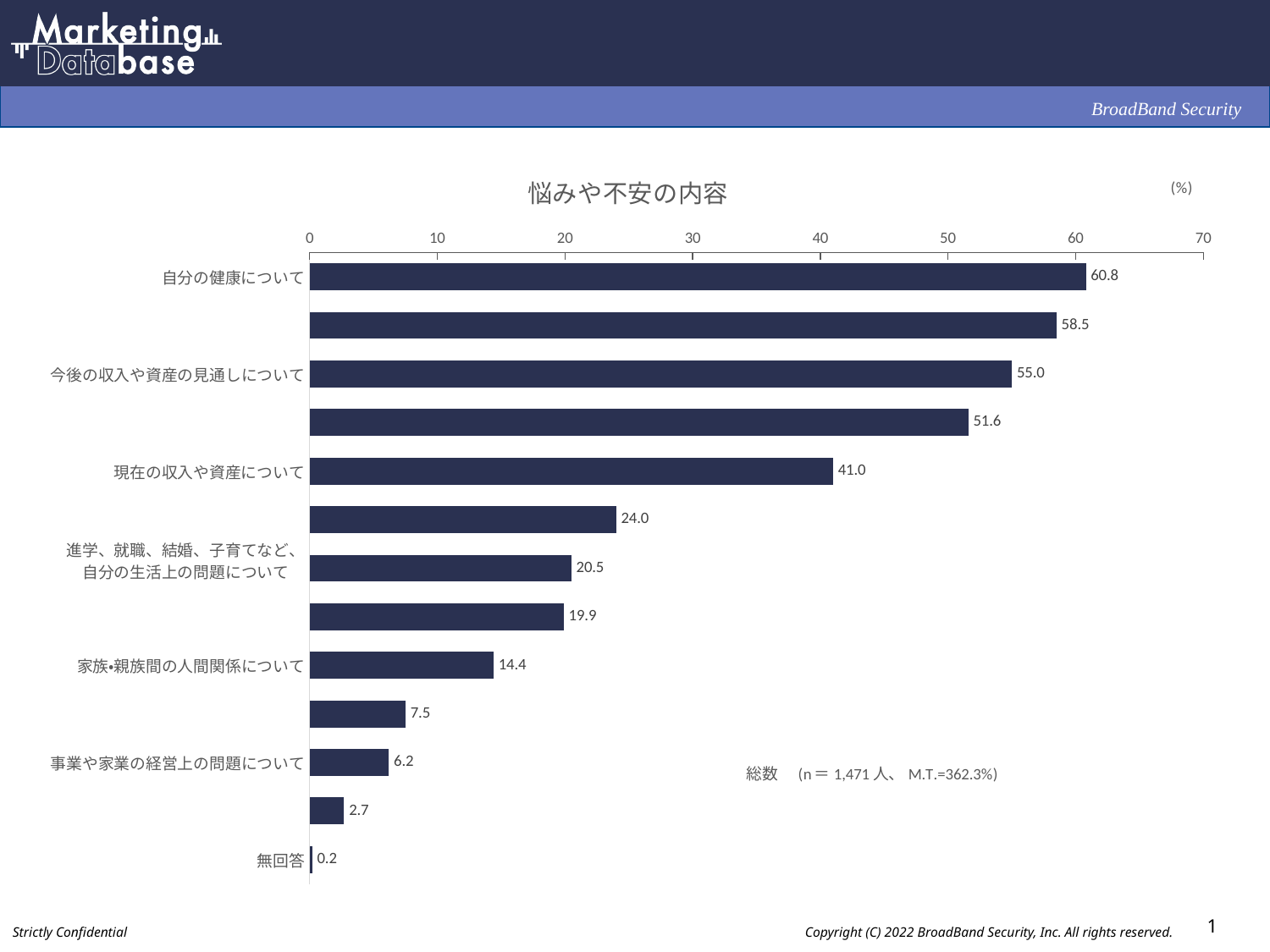
What is the value for 自分の健康について? 60.8 What is the value for 事業や家業の経営上の問題について? 6.2 What is the value for 無回答? 0.2 How many bars are plotted in the chart? 13 Which is larger, the value for 今後の収入や資産の見通しについて or the value for 家族•親族間の人間関係について? 今後の収入や資産の見通しについて What type of chart is shown on the slide? Bar chart Which category has the highest value? 自分の健康について What is the value for 家族•親族間の人間関係について? 14.4 Which category has the lowest value? 無回答 What is the value for 現在の収入や資産について? 41.0 What is the value for 今後の収入や資産の見通しについて? 55.0 What is the difference between the values for 自分の健康について and 現在の収入や資産について? 19.8